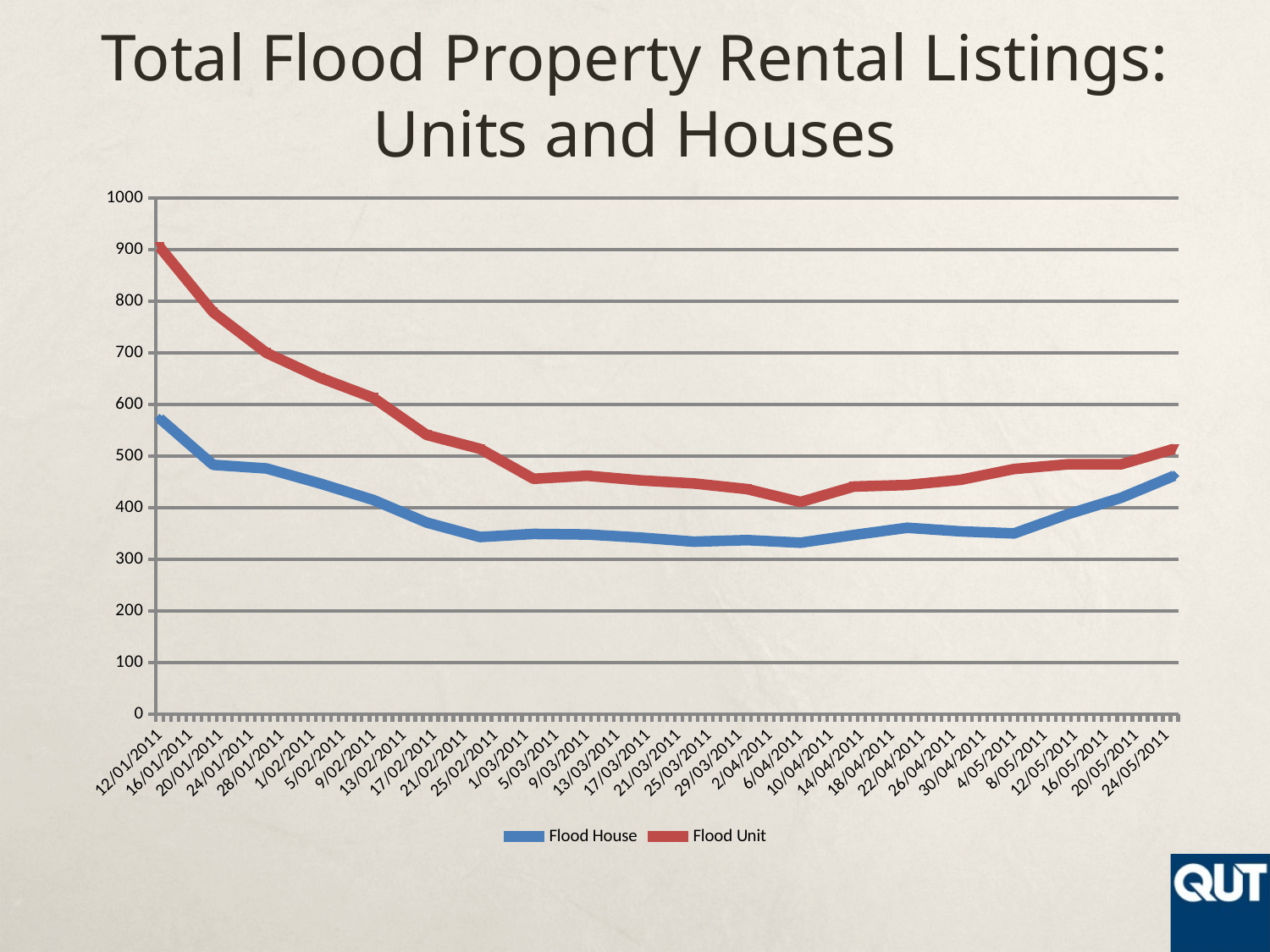
Is the Flood Unit value on 24/05/2011 greater or less than 500? greater On which date does the Flood Unit series reach its highest value? 12/01/2011 On which date does the Flood Unit series reach its lowest value? 6/04/2011 What are the two series named in the legend? Flood House and Flood Unit Does the Flood Unit line rise or fall between 12/01/2011 and 1/03/2011? fall Which colour is used for the Flood Unit line? red Is the Flood House value on 6/04/2011 greater or less than 400? less Is the Flood House value on 12/01/2011 greater or less than 500? greater What kind of chart is shown on the slide? line chart On 12/01/2011, which series has the larger value, Flood House or Flood Unit? Flood Unit How many series does the legend list? 2